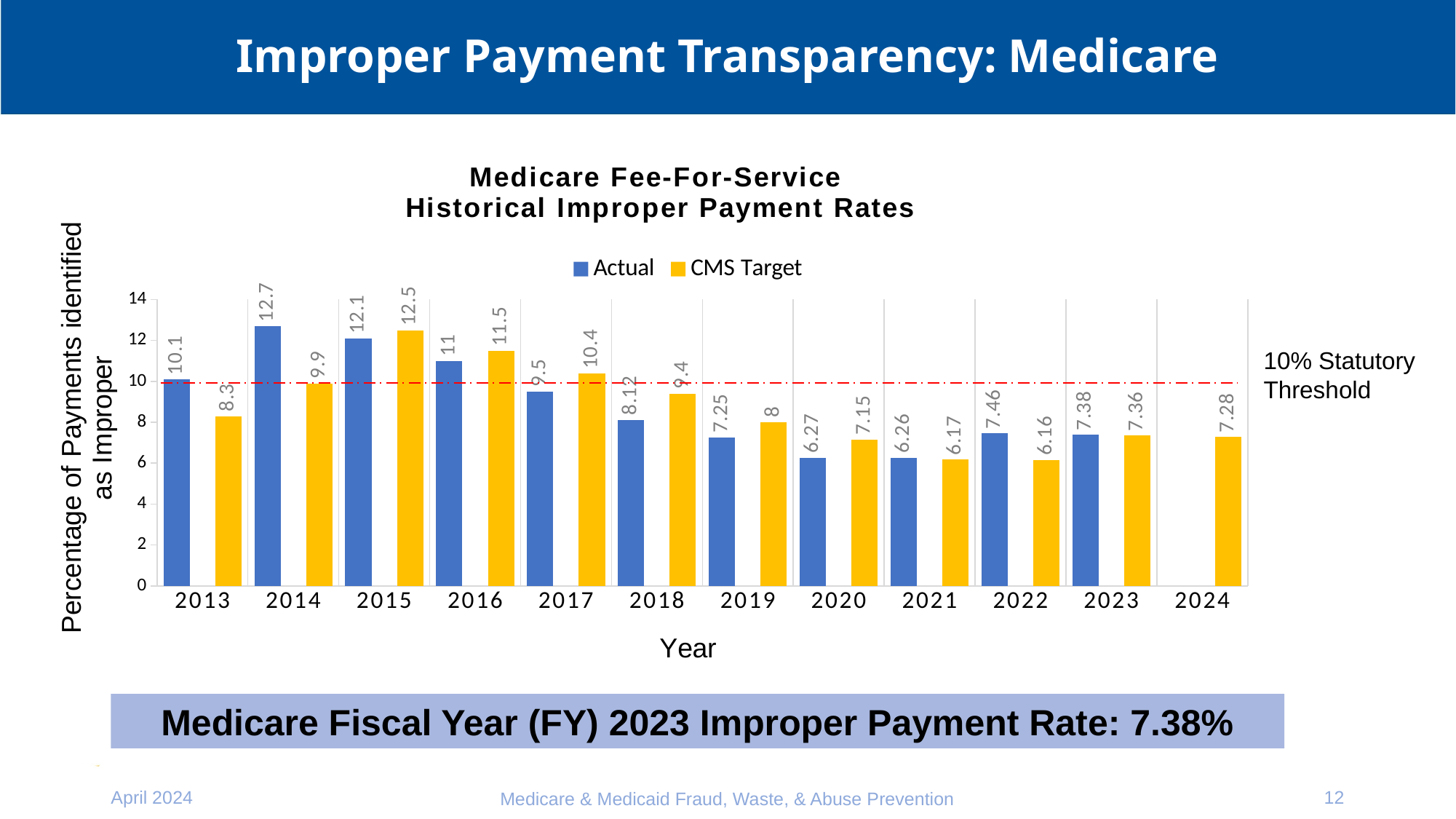
What is the CMS Target value for 2024? 7.28 How many years are shown on the x axis? 12 Which year has the highest Actual improper payment rate? 2014 How many series does the legend list? 2 Which is larger for 2019, the Actual value or the CMS Target value? CMS Target Is the Actual value for 2016 greater or less than 10? greater Which year has the lowest CMS Target value? 2022 What is the Actual improper payment rate for 2014? 12.7 What kind of chart is shown on the slide? Bar chart What is the Actual value for 2023? 7.38 What does the red dashed horizontal line represent? 10% Statutory Threshold What is the difference between the Actual value and the CMS Target value for 2015? 0.4